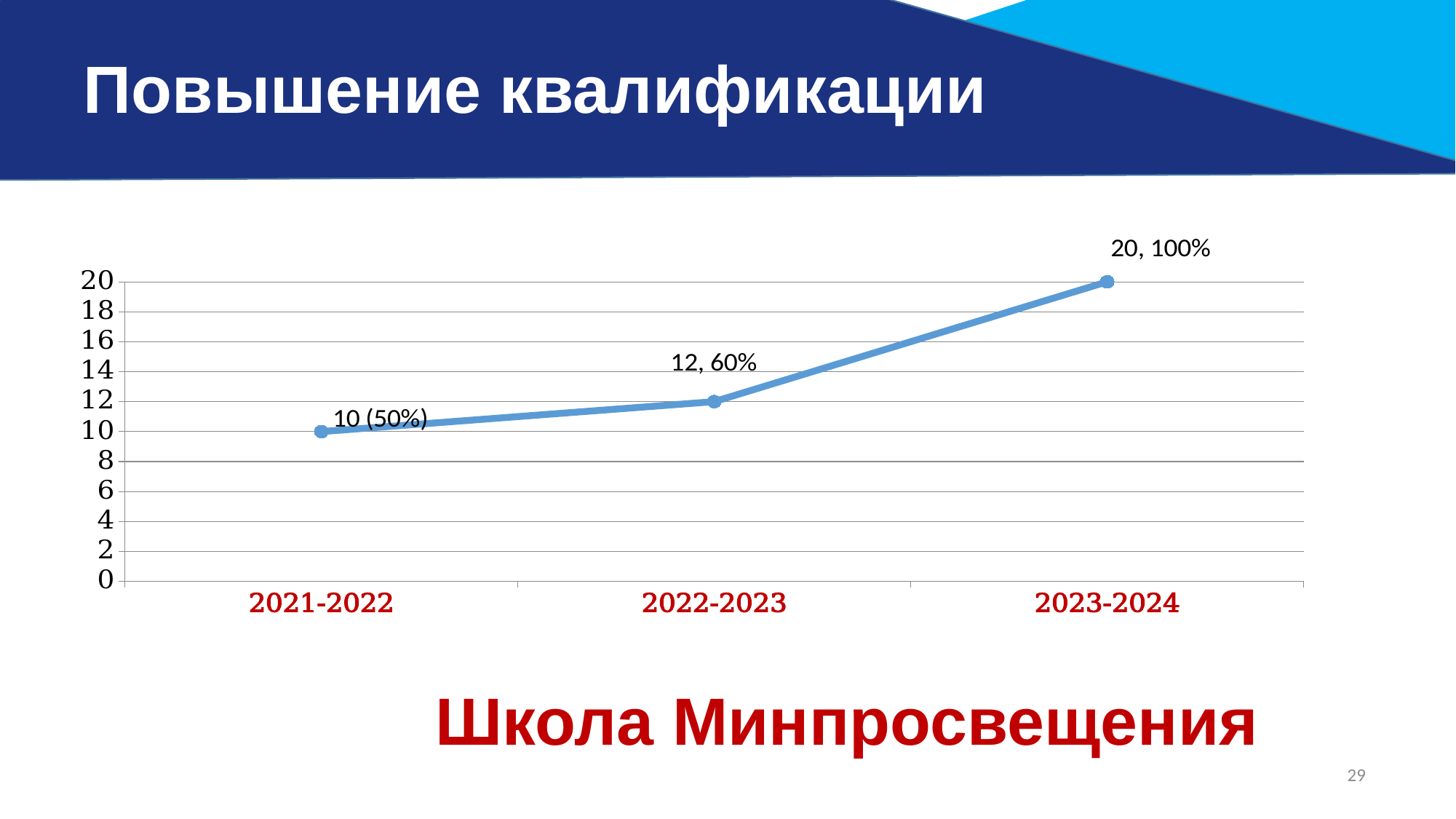
What is the data label shown for 2023-2024? 20, 100% What is the difference between the values for 2022-2023 and 2021-2022? 2 What is the difference between the values for 2023-2024 and 2021-2022? 10 What is the data label shown for 2022-2023? 12, 60% Do the values rise or fall from 2021-2022 to 2023-2024? rise What is the data label shown for 2021-2022? 10 (50%) Is the value for 2022-2023 greater or less than 10? greater Which is larger, the value for 2022-2023 or the value for 2023-2024? 2023-2024 Which period has the highest value? 2023-2024 What kind of chart is shown on the slide? line chart How many periods are plotted on the x axis? 3 Which period has the lowest value? 2021-2022